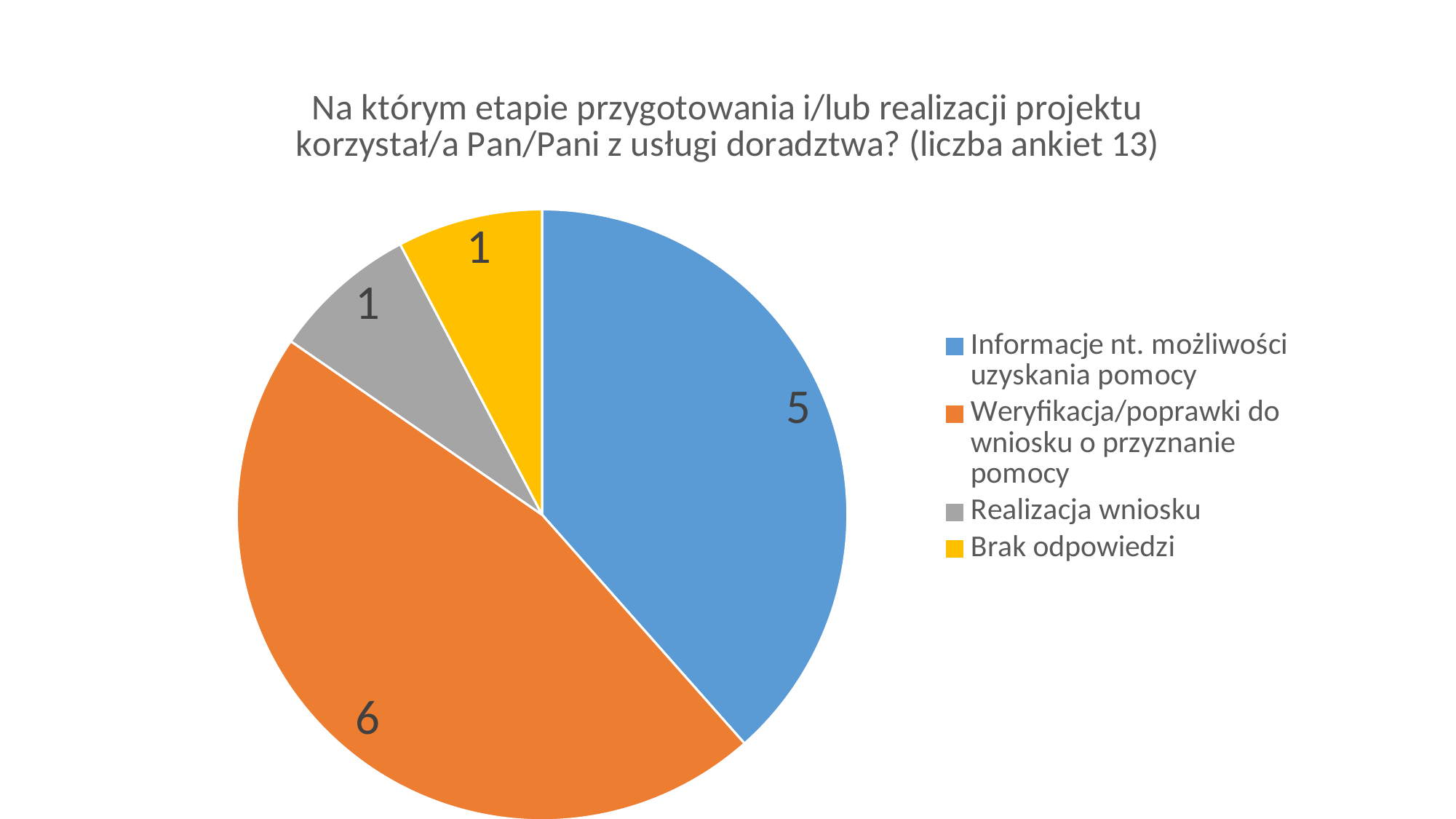
How many surveys (ankiet) does the chart title say were counted? 13 What is the value for "Weryfikacja/poprawki do wniosku o przyznanie pomocy"? 6 How many categories does the pie chart have? 4 What colour is the slice for "Brak odpowiedzi"? yellow Which is larger: the value for "Informacje nt. możliwości uzyskania pomocy" or the value for "Realizacja wniosku"? Informacje nt. możliwości uzyskania pomocy What is the value for "Brak odpowiedzi"? 1 What is the value for "Informacje nt. możliwości uzyskania pomocy"? 5 What is the total of all slices in the pie chart? 13 What is the difference between the values for "Weryfikacja/poprawki do wniosku o przyznanie pomocy" and "Informacje nt. możliwości uzyskania pomocy"? 1 What kind of chart is shown on the slide? pie chart What is the value for "Realizacja wniosku"? 1 Which category has the largest slice? Weryfikacja/poprawki do wniosku o przyznanie pomocy